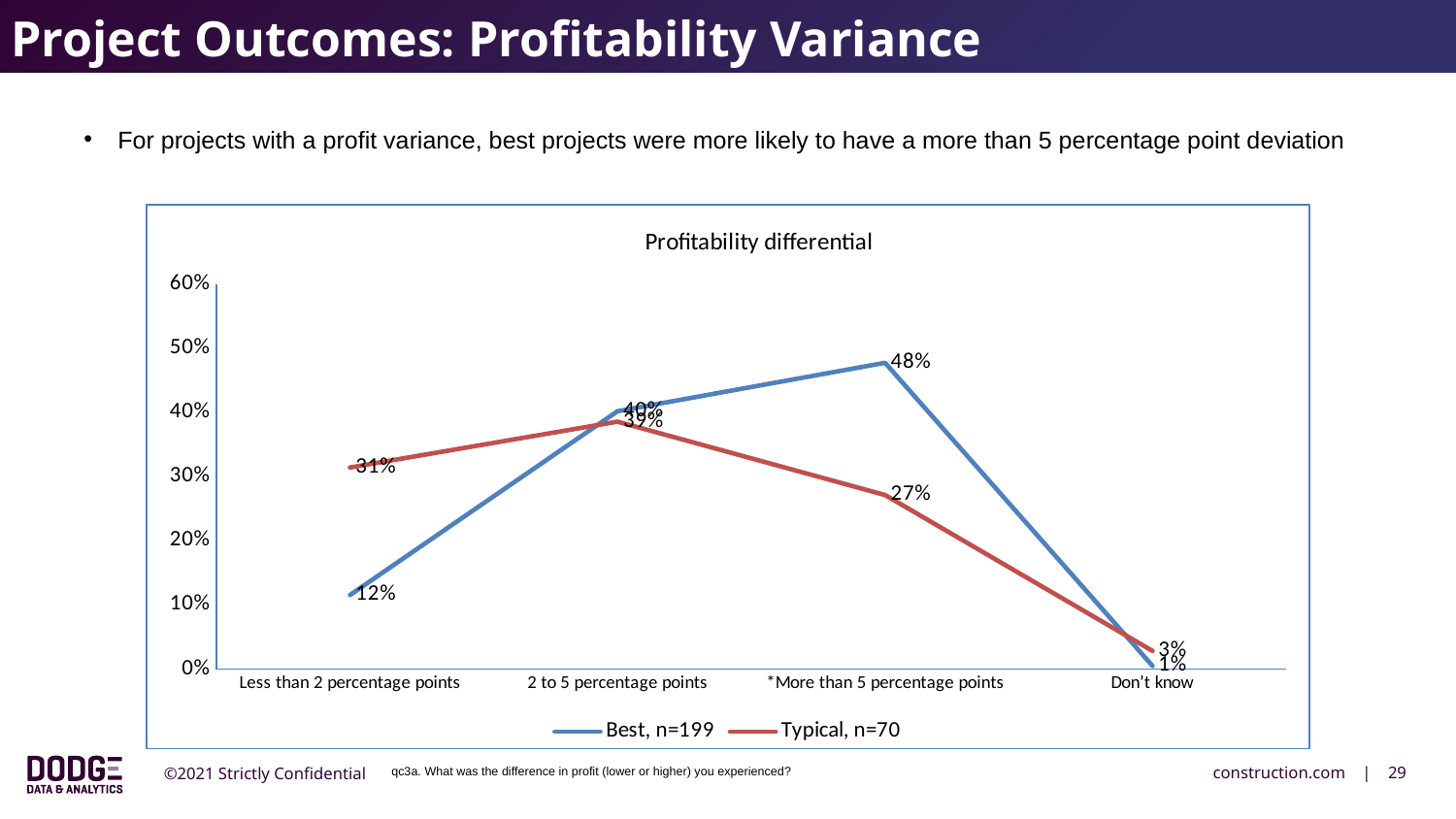
How many series does the legend list? 2 What type of chart is shown on the slide? line chart What is the title of the chart? Profitability differential Which category has the highest value for Best, n=199? *More than 5 percentage points What is the difference between Best, n=199 and Typical, n=70 at *More than 5 percentage points? 21% How many categories are shown on the x axis? 4 What is the value for Best, n=199 at *More than 5 percentage points? 48% Is the value for Typical, n=70 at 2 to 5 percentage points greater or less than 30%? greater Which category has the lowest value for Typical, n=70? Don't know What is the value for Typical, n=70 at Less than 2 percentage points? 31% What is the value for Best, n=199 at Less than 2 percentage points? 12% What is the value for Typical, n=70 at *More than 5 percentage points? 27%